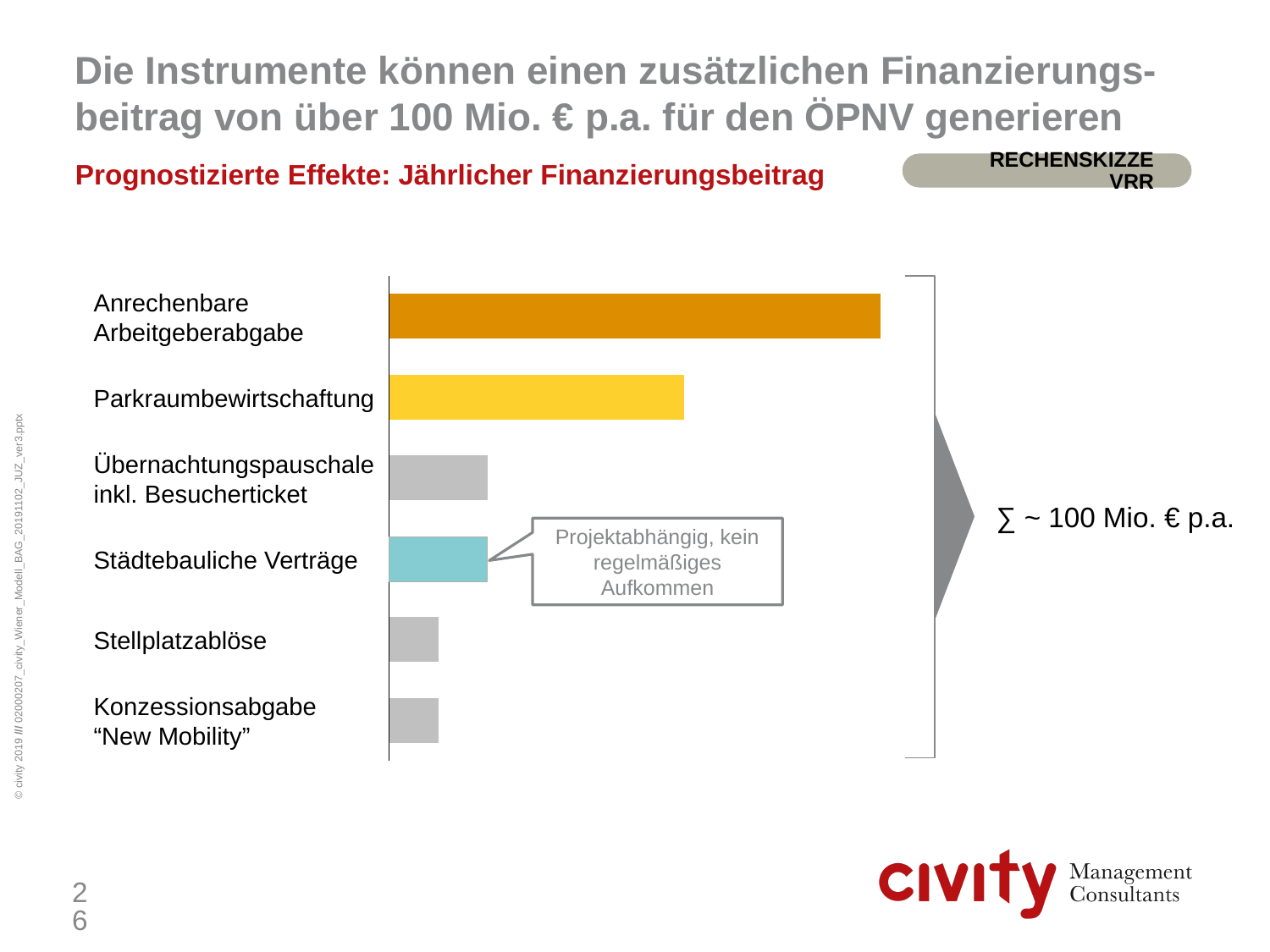
Which bar is longer: Übernachtungspauschale inkl. Besucherticket or Stellplatzablöse? Übernachtungspauschale inkl. Besucherticket Which bar is longer: Parkraumbewirtschaftung or Übernachtungspauschale inkl. Besucherticket? Parkraumbewirtschaftung What is the subtitle (chart heading) shown in red above the chart? Prognostizierte Effekte: Jährlicher Finanzierungsbeitrag What total is indicated by the arrow to the right of the chart? ∑ ~ 100 Mio. € p.a. How many categories (instruments) are shown in the chart? 6 Which category has the longest bar in the chart? Anrechenbare Arbeitgeberabgabe Which bar is longer: Anrechenbare Arbeitgeberabgabe or Parkraumbewirtschaftung? Anrechenbare Arbeitgeberabgabe What kind of chart is shown on the slide? bar chart